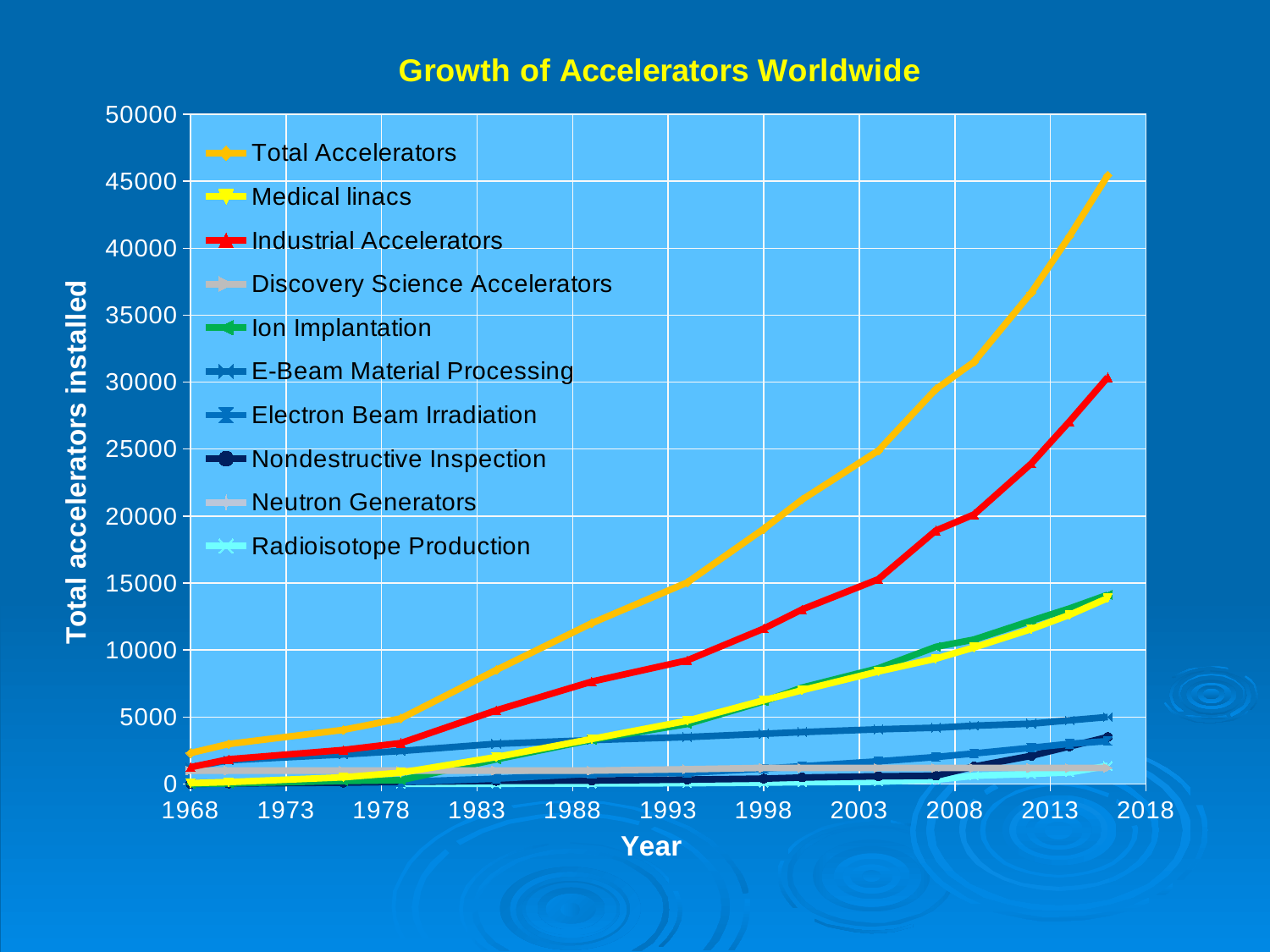
What is the label of the y axis? Total accelerators installed Which is larger in 2003: Total Accelerators or Electron Beam Irradiation? Total Accelerators Is the value for Total Accelerators in 1988 greater or less than 10000? greater What is the title of the chart? Growth of Accelerators Worldwide At the last plotted point, which is larger: Industrial Accelerators or Medical linacs? Industrial Accelerators What kind of chart is shown on the slide? line chart Does the Total Accelerators series rise or fall over the years shown? rise Is the value for Total Accelerators in 1998 greater or less than 20000? less Is the value for Industrial Accelerators in 1993 greater or less than 10000? less Which series has the highest value in the final year plotted? Total Accelerators How many series does the legend list? 10